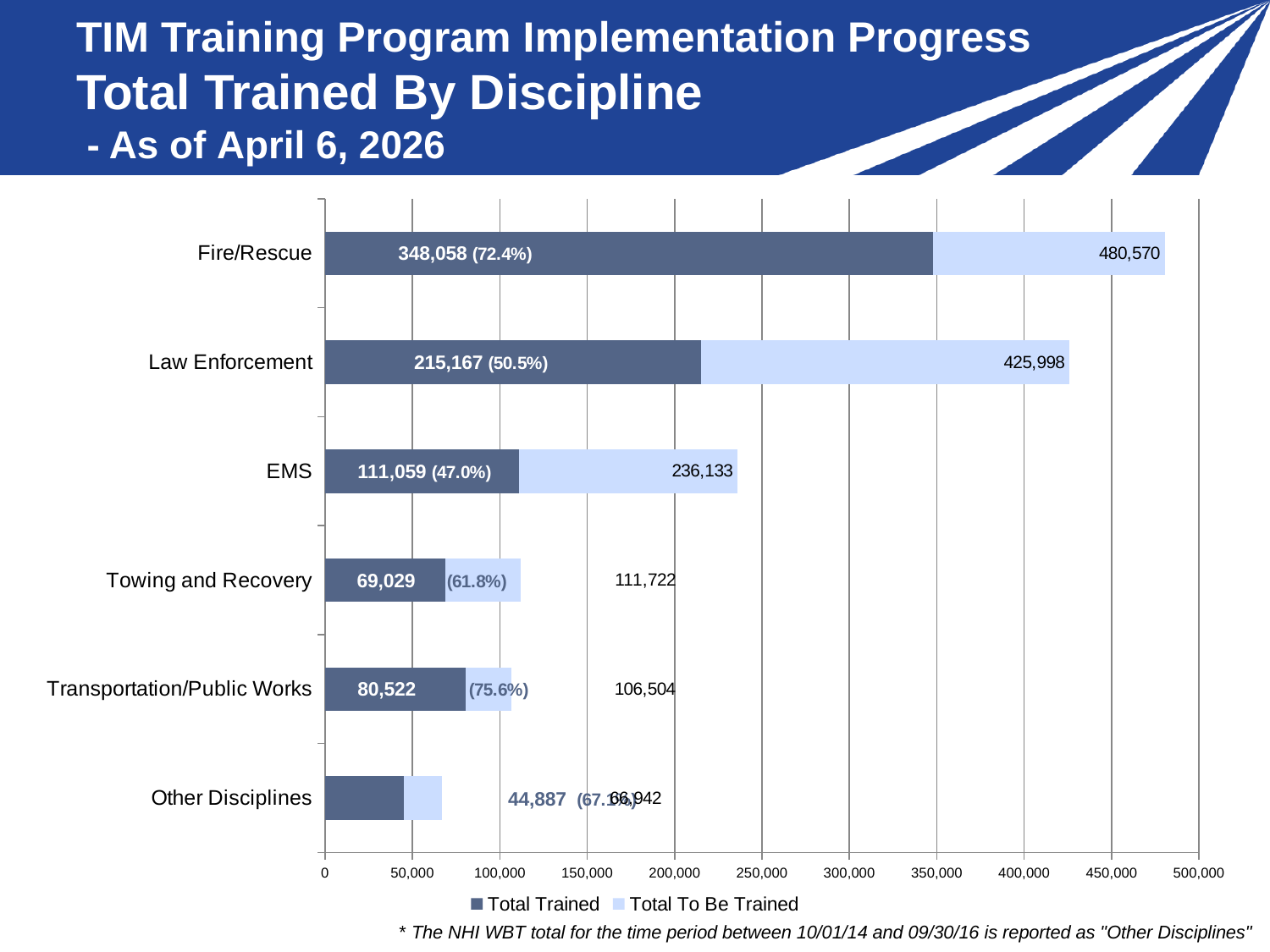
How many series does the legend list? 2 Which has a larger Total Trained value, Towing and Recovery or Transportation/Public Works? Transportation/Public Works Is the Total To Be Trained value for EMS greater or less than 250,000? less What is the Total To Be Trained value shown for Law Enforcement? 425,998 What is the Total To Be Trained value shown for Towing and Recovery? 111,722 Which discipline has the highest Total Trained value? Fire/Rescue What percentage is shown next to the Total Trained value for EMS? 47.0% What is the Total Trained value for Fire/Rescue? 348,058 Which discipline has the lowest Total Trained value? Other Disciplines What kind of chart is shown on the slide? bar chart How many disciplines are listed on the chart? 6 What is the difference between the Total Trained values for Fire/Rescue and Law Enforcement? 132,891